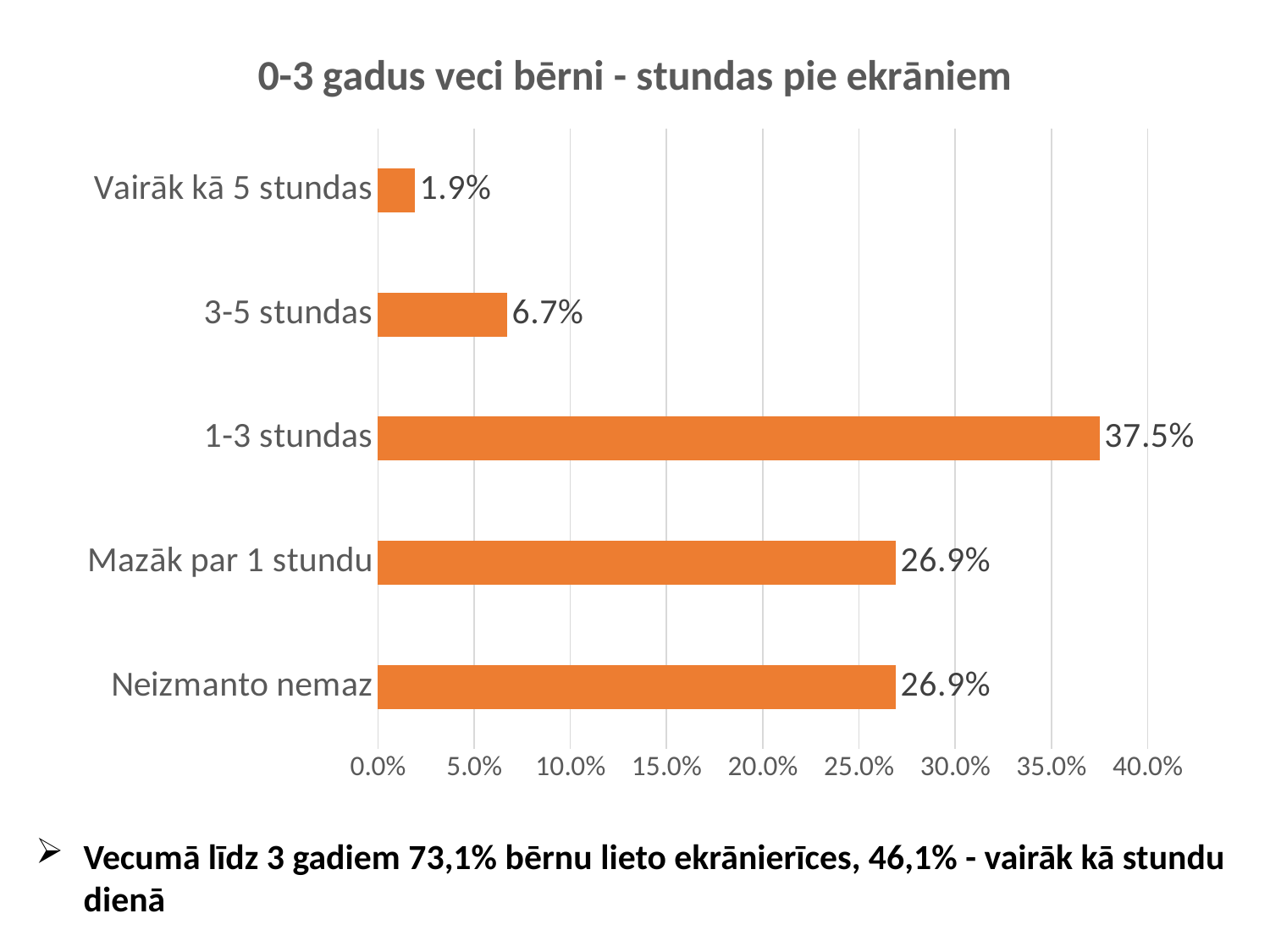
What kind of chart is shown on the slide? Bar chart What is the value for "Neizmanto nemaz"? 26.9% Which is larger, the value for "3-5 stundas" or the value for "Vairāk kā 5 stundas"? 3-5 stundas What is the value for "Vairāk kā 5 stundas"? 1.9% What is the title of the chart? 0-3 gadus veci bērni - stundas pie ekrāniem What is the value for "3-5 stundas"? 6.7% What is the value for "1-3 stundas"? 37.5% What is the difference between the values for "1-3 stundas" and "Mazāk par 1 stundu"? 10.6% How many categories are shown in the chart? 5 Is the value for "Mazāk par 1 stundu" greater or less than 25.0%? greater Which category has the highest value? 1-3 stundas Which category has the lowest value? Vairāk kā 5 stundas